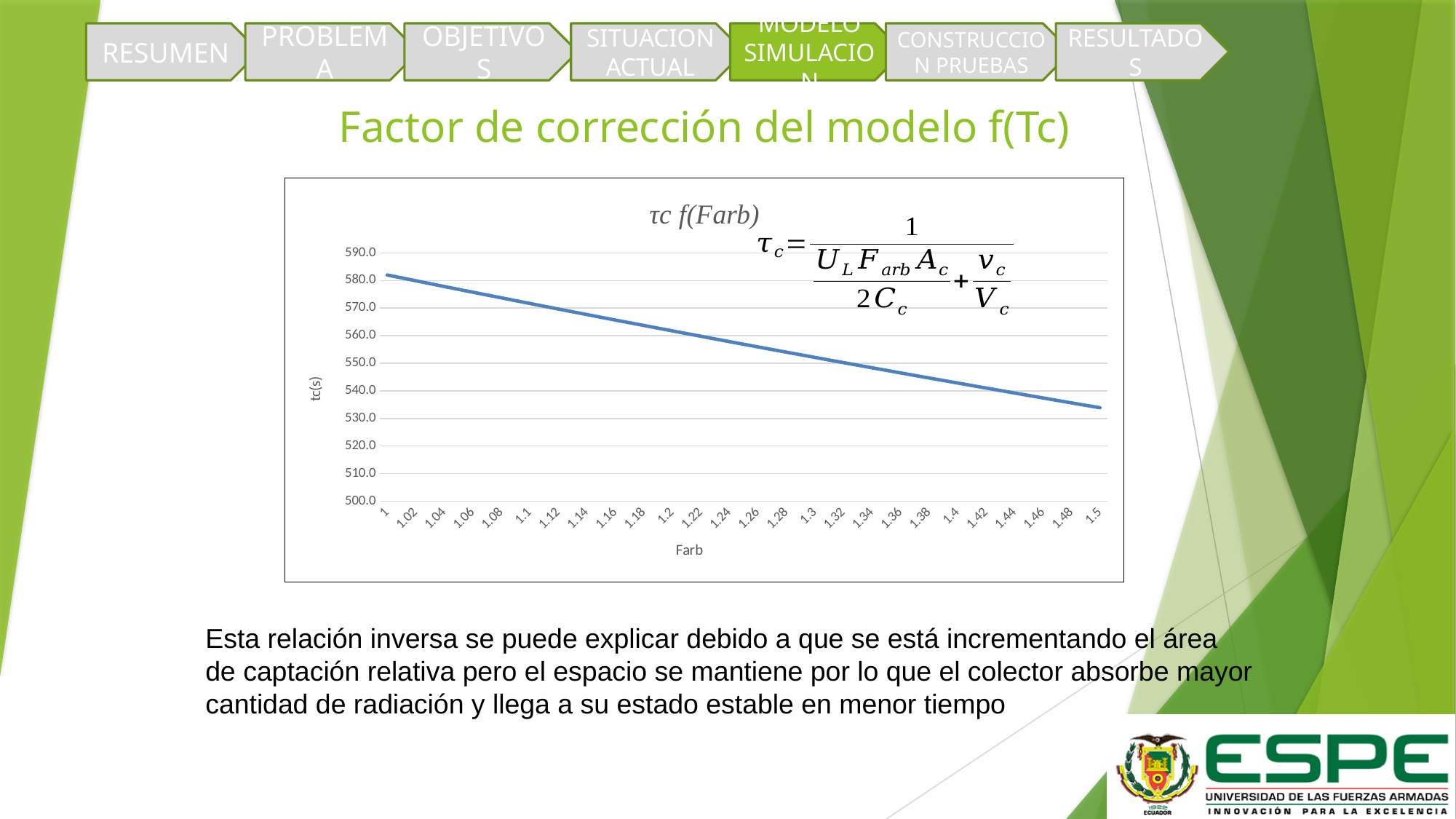
At which Farb value is tc highest? 1 Is the value of tc at Farb = 1.5 greater or less than 540? less Is the value of tc at Farb = 1.2 greater or less than 550? greater How many Farb values are labelled on the x axis of the chart? 26 What is the label of the vertical axis of the chart? tc(s) At which Farb value is tc lowest? 1.5 Is the value of tc at Farb = 1.4 greater or less than 550? less What kind of chart is shown on the slide? line chart What is the title of the chart? τc f(Farb) Which has a larger tc value, Farb = 1.1 or Farb = 1.3? Farb = 1.1 Do the values of tc rise or fall as Farb increases along the x axis? fall